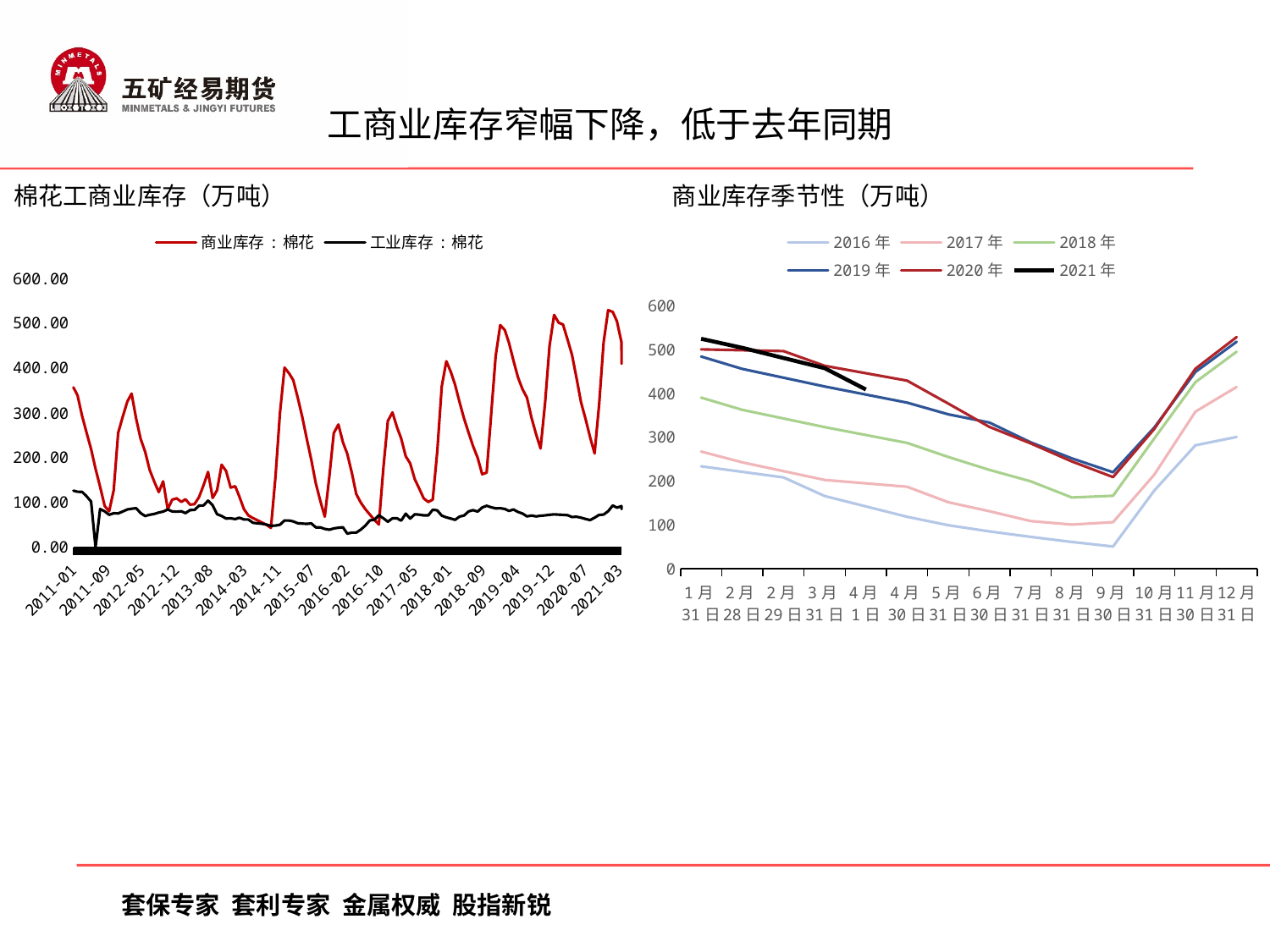
In the right chart (商业库存季节性), which year's line is lowest at 9月30日? 2016年 How many series does the legend of the left chart (棉花工商业库存) list? 2 How many series does the legend of the right chart (商业库存季节性) list? 6 What kind of chart is the left chart titled 棉花工商业库存（万吨）? line chart In the left chart (棉花工商业库存), which series is drawn in red? 商业库存：棉花 In the right chart (商业库存季节性), do the yearly lines generally rise or fall from 1月31日 to 9月30日? fall In the right chart (商业库存季节性), is the value for 2021年 at 1月31日 greater or less than 500? greater In the right chart (商业库存季节性), which is larger at 9月30日: the 2020年 value or the 2016年 value? 2020年 In the right chart (商业库存季节性), which year is drawn as the thick black line? 2021年 In the right chart (商业库存季节性), is the value for 2016年 at 9月30日 greater or less than 100? less In the right chart (商业库存季节性), which year's line is lowest at 1月31日? 2016年 In the right chart (商业库存季节性), is the value for 2018年 at 8月31日 greater or less than 200? less